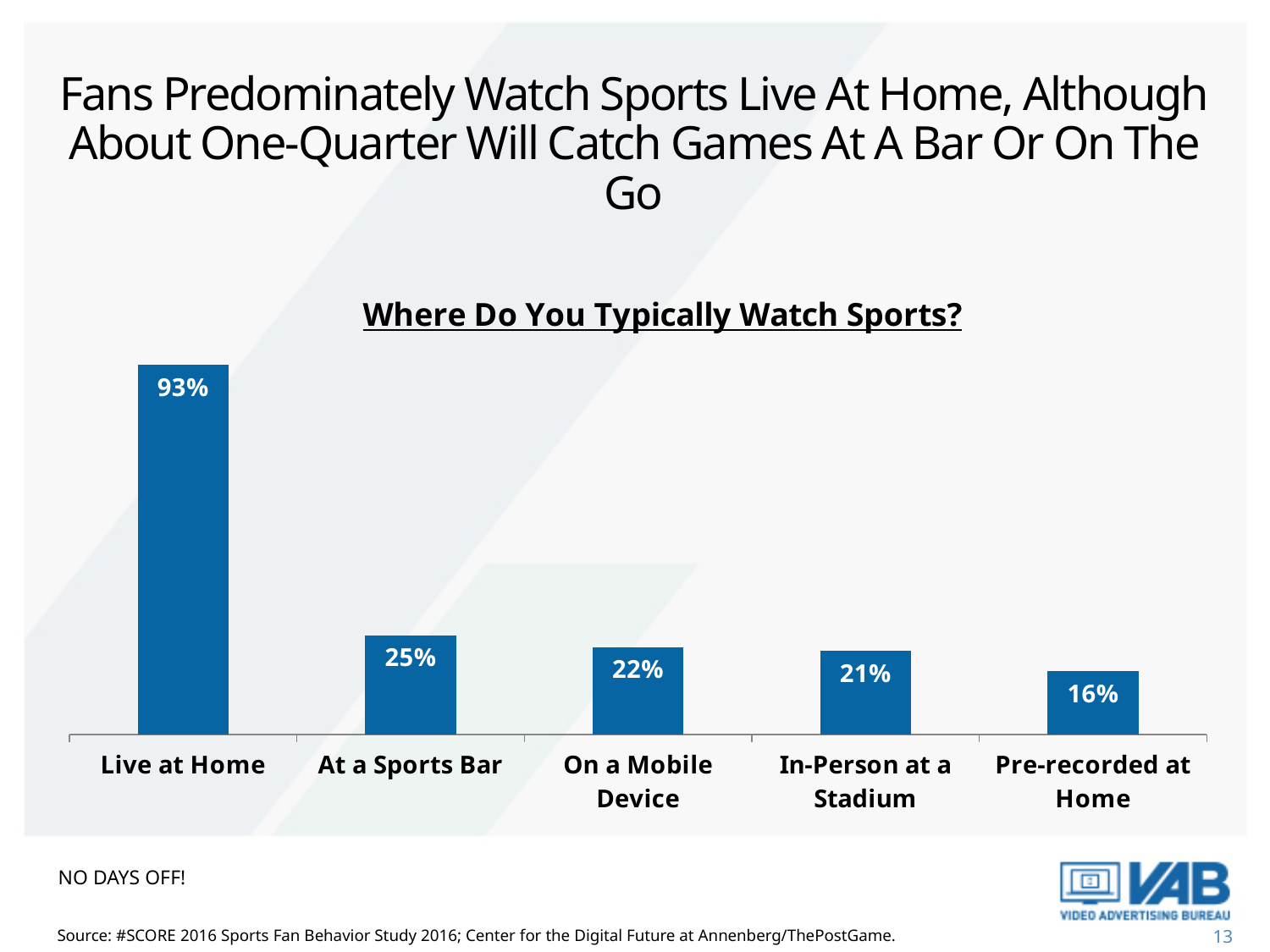
What percentage of fans typically watch sports on a mobile device? 22% Which category has the lowest value? Pre-recorded at Home What is the value for 'Pre-recorded at Home'? 16% Which category has the highest value? Live at Home How many categories are shown in the chart? 5 What is the title of the chart? Where Do You Typically Watch Sports? What is the value for 'At a Sports Bar'? 25% What kind of chart is shown on the slide? Bar chart What percentage of fans typically watch sports live at home? 93% Which is larger, the value for 'On a Mobile Device' or 'Pre-recorded at Home'? On a Mobile Device What is the difference between 'In-Person at a Stadium' and 'Pre-recorded at Home'? 5% What is the difference between the values for 'Live at Home' and 'At a Sports Bar'? 68%